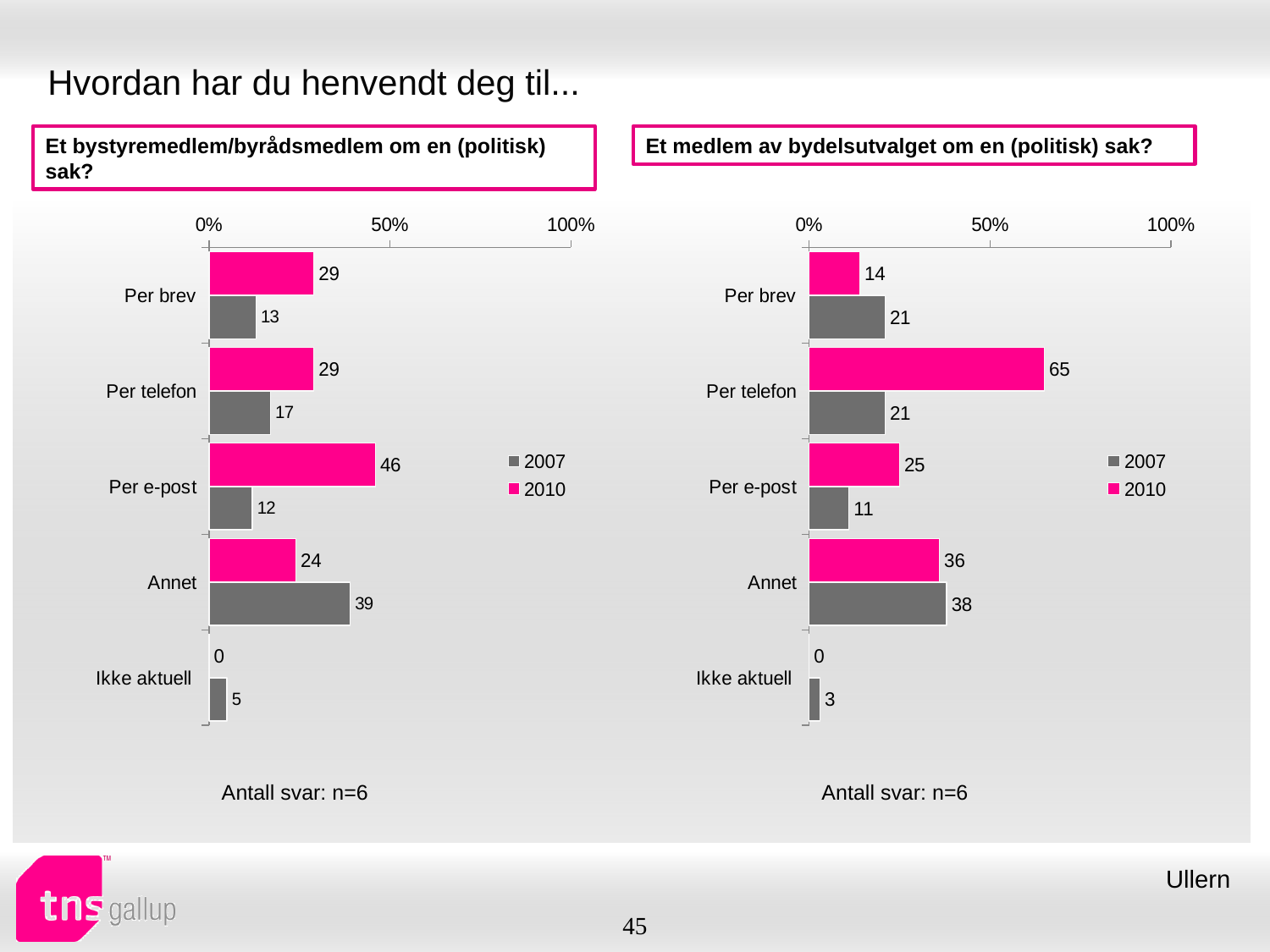
In the left chart, what is the 2007 value for Annet? 39 In the left chart, what is the difference between the 2010 and 2007 values for Per e-post? 34 What kind of chart is the left chart? Bar chart In the right chart (Et medlem av bydelsutvalget om en (politisk) sak?), what is the 2010 value for Per telefon? 65 In the right chart, which category has the lowest 2007 value? Ikke aktuell In the left chart (Et bystyremedlem/byrådsmedlem om en (politisk) sak?), what is the 2010 value for Per e-post? 46 In the right chart, which is larger for Annet: the 2007 value or the 2010 value? 2007 In the right chart, is the 2010 value for Per telefon greater or less than 50%? greater How many series does the legend of the right chart list? 2 In the right chart, what is the 2007 value for Per brev? 21 In the left chart, which category has the highest 2010 value? Per e-post How many categories are shown in the left chart? 5